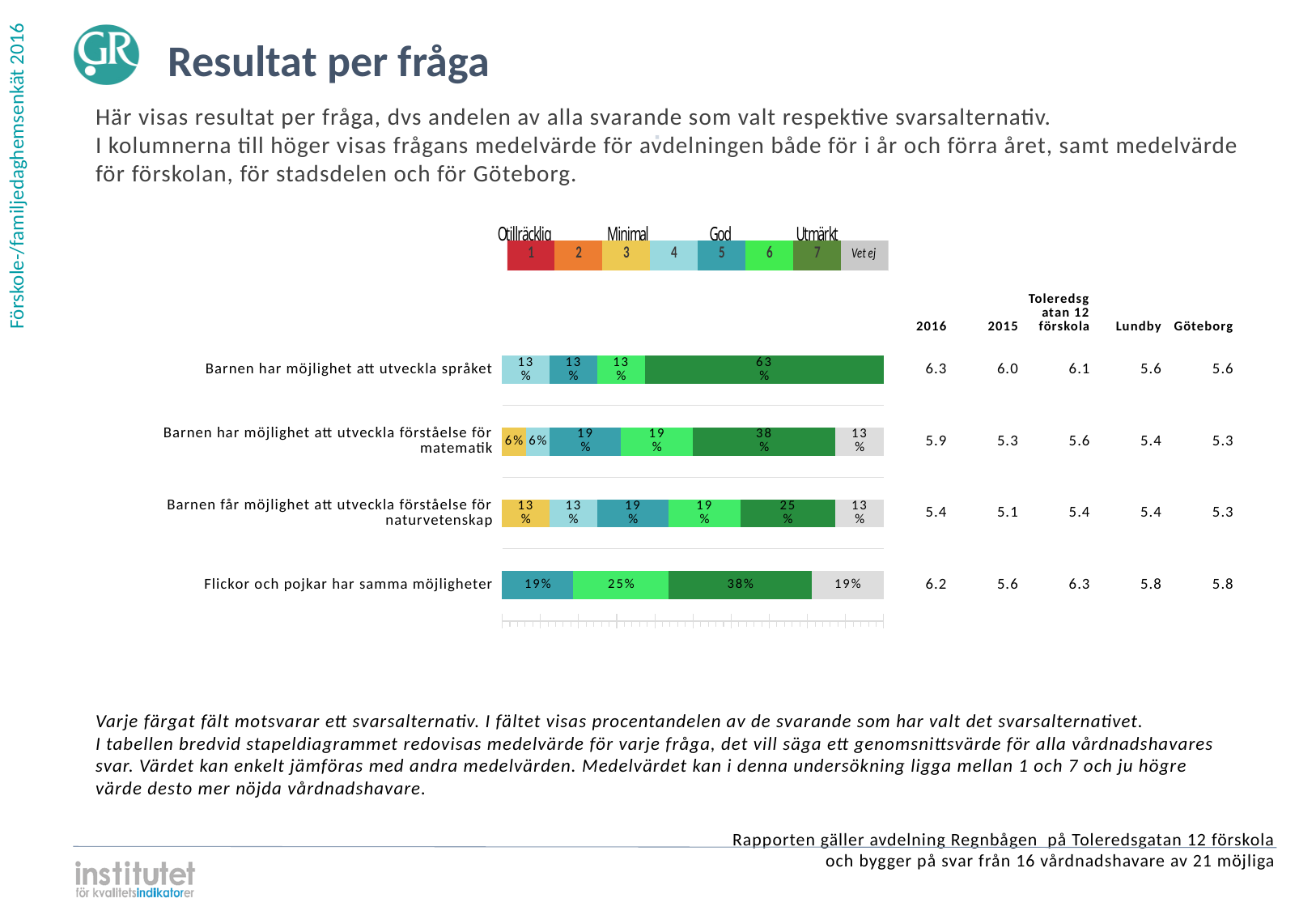
How many response options does the legend above the chart list, including 'Vet ej'? 8 What is the 2016 mean value shown for 'Barnen har möjlighet att utveckla språket'? 6.3 What percentage of respondents chose 7 (dark green) for 'Barnen får möjlighet att utveckla förståelse för naturvetenskap'? 25% What is the Göteborg mean value shown for 'Flickor och pojkar har samma möjligheter'? 5.8 What kind of chart is shown on the slide? Stacked bar chart What percentage of respondents chose 7 (dark green) for 'Barnen har möjlighet att utveckla språket'? 63% What percentage of respondents chose 'Vet ej' for 'Flickor och pojkar har samma möjligheter'? 19% What percentage of respondents chose 3 (yellow) for 'Barnen har möjlighet att utveckla förståelse för matematik'? 6% Which is larger: the 6 (light green) share for 'Flickor och pojkar har samma möjligheter' or for 'Barnen har möjlighet att utveckla förståelse för matematik'? Flickor och pojkar har samma möjligheter What is the difference between the 7 (dark green) share for 'Barnen har möjlighet att utveckla språket' and for 'Flickor och pojkar har samma möjligheter'? 25 percentage points Which question has the largest share of respondents choosing 7 (dark green)? Barnen har möjlighet att utveckla språket How many questions (categories) are plotted in the bar chart? 4